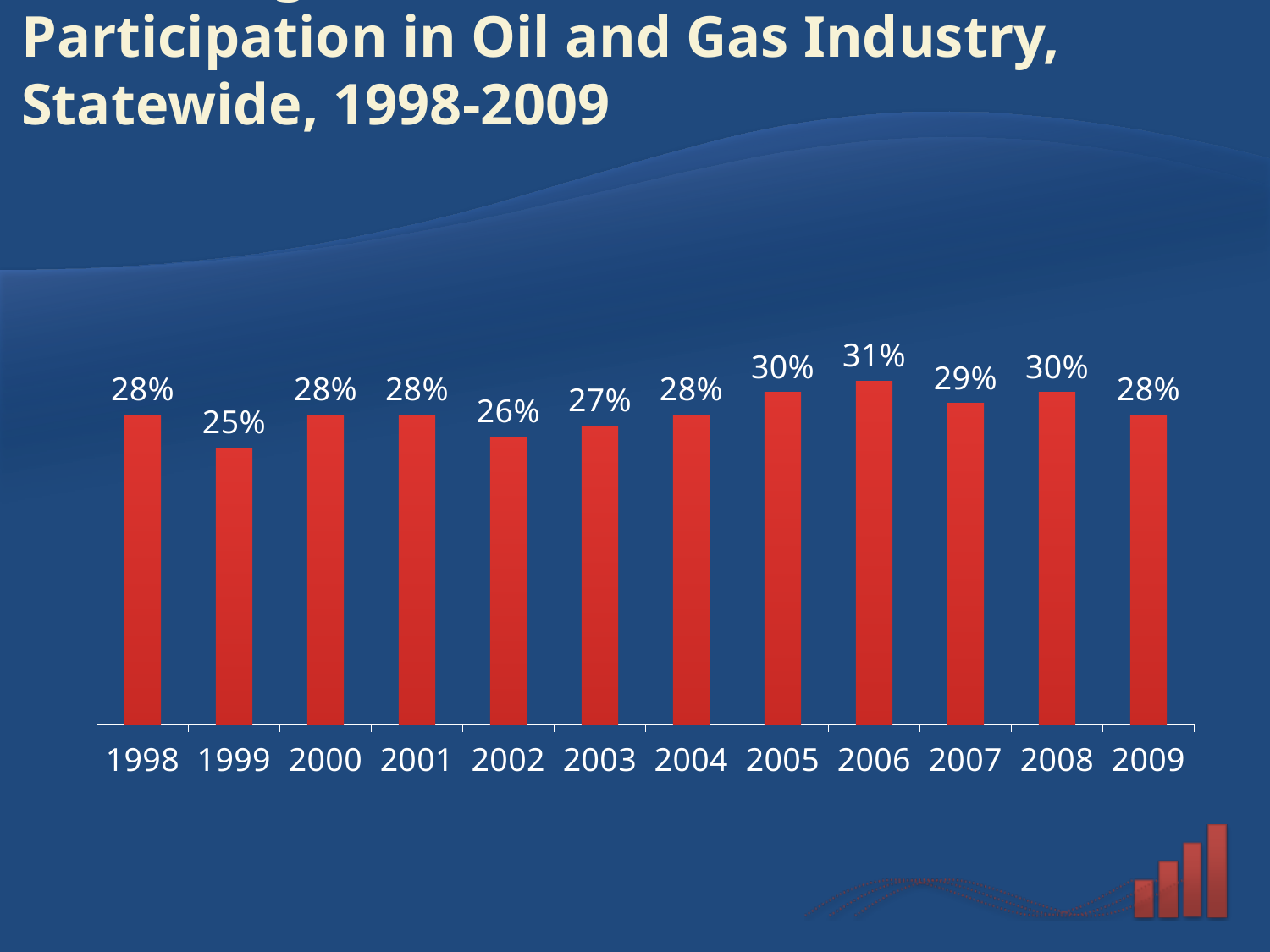
Do the values rise or fall from 2002 to 2006? Rise What is the value for 1999? 25% Which year has the highest value? 2006 Which year has the lowest value? 1999 What is the value for 2003? 27% Which is larger, the value for 2005 or the value for 2002? 2005 What colour are the bars in the chart? Red What is the value for 2009? 28% What is the difference between the values for 2006 and 1999? 6% How many years are shown on the x axis? 12 What kind of chart is shown on the slide? Bar chart What is the value for 2006? 31%